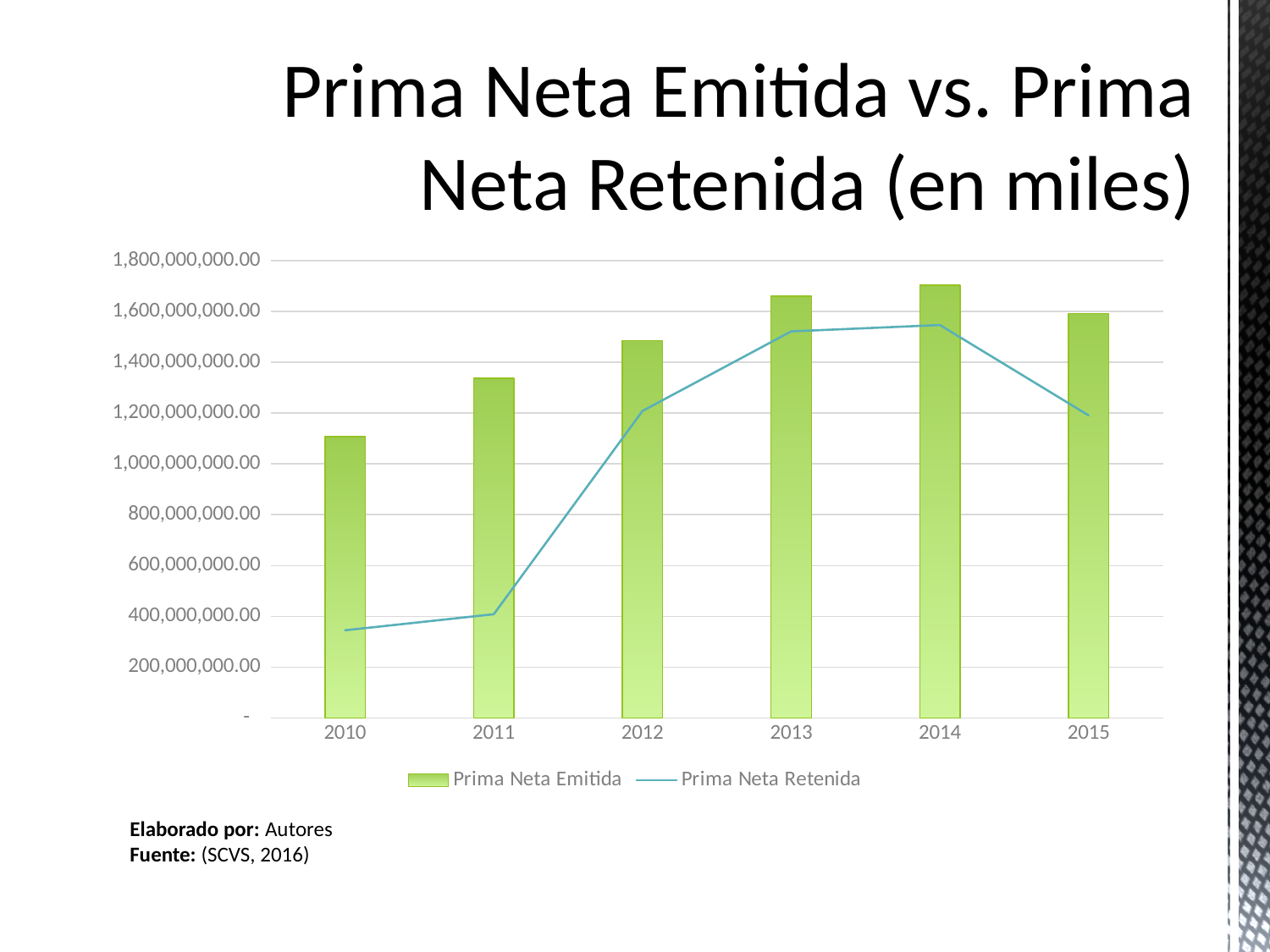
Which year has the lowest value for Prima Neta Retenida? 2010 Is the Prima Neta Retenida value for 2010 greater or less than 400,000,000.00? less Does Prima Neta Retenida rise or fall from 2014 to 2015? Fall Which year has the highest Prima Neta Emitida bar? 2014 What kind of chart is shown on the slide? A combined bar and line chart Is the Prima Neta Retenida value for 2012 greater or less than 1,000,000,000.00? greater Is the Prima Neta Emitida value for 2013 greater or less than 1,600,000,000.00? greater In 2011, which is larger: Prima Neta Emitida or Prima Neta Retenida? Prima Neta Emitida How many years are shown on the x axis? 6 Which year has the lowest Prima Neta Emitida bar? 2010 How many series does the legend list? 2